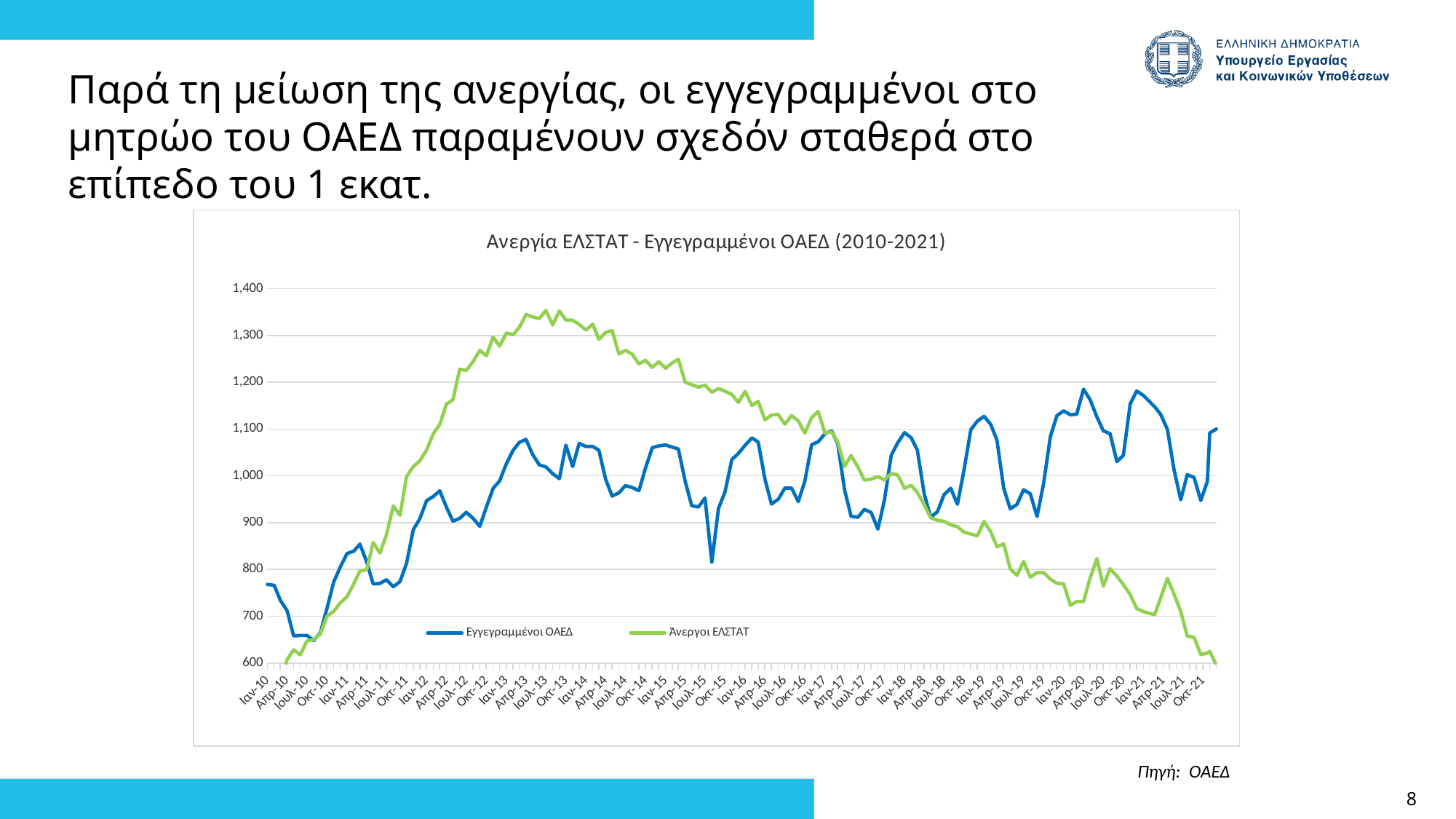
Is the value of Άνεργοι ΕΛΣΤΑΤ at Οκτ-21 greater or less than 700? less At Οκτ-21, which series has the larger value, Εγγεγραμμένοι ΟΑΕΔ or Άνεργοι ΕΛΣΤΑΤ? Εγγεγραμμένοι ΟΑΕΔ Is the value of Εγγεγραμμένοι ΟΑΕΔ at Απρ-20 greater or less than 1,100? greater Which series is drawn in green in the chart? Άνεργοι ΕΛΣΤΑΤ How many series does the chart's legend list? 2 Is the value of Άνεργοι ΕΛΣΤΑΤ at Ιουλ-13 greater or less than 1,300? greater Which series reaches the highest value anywhere on the chart? Άνεργοι ΕΛΣΤΑΤ At Ιαν-13, which series has the larger value, Εγγεγραμμένοι ΟΑΕΔ or Άνεργοι ΕΛΣΤΑΤ? Άνεργοι ΕΛΣΤΑΤ What kind of chart is shown on the slide? Line chart What is the title of the chart? Ανεργία ΕΛΣΤΑΤ - Εγγεγραμμένοι ΟΑΕΔ (2010-2021) Does the Άνεργοι ΕΛΣΤΑΤ line rise or fall between Ιουλ-13 and Οκτ-21? Fall